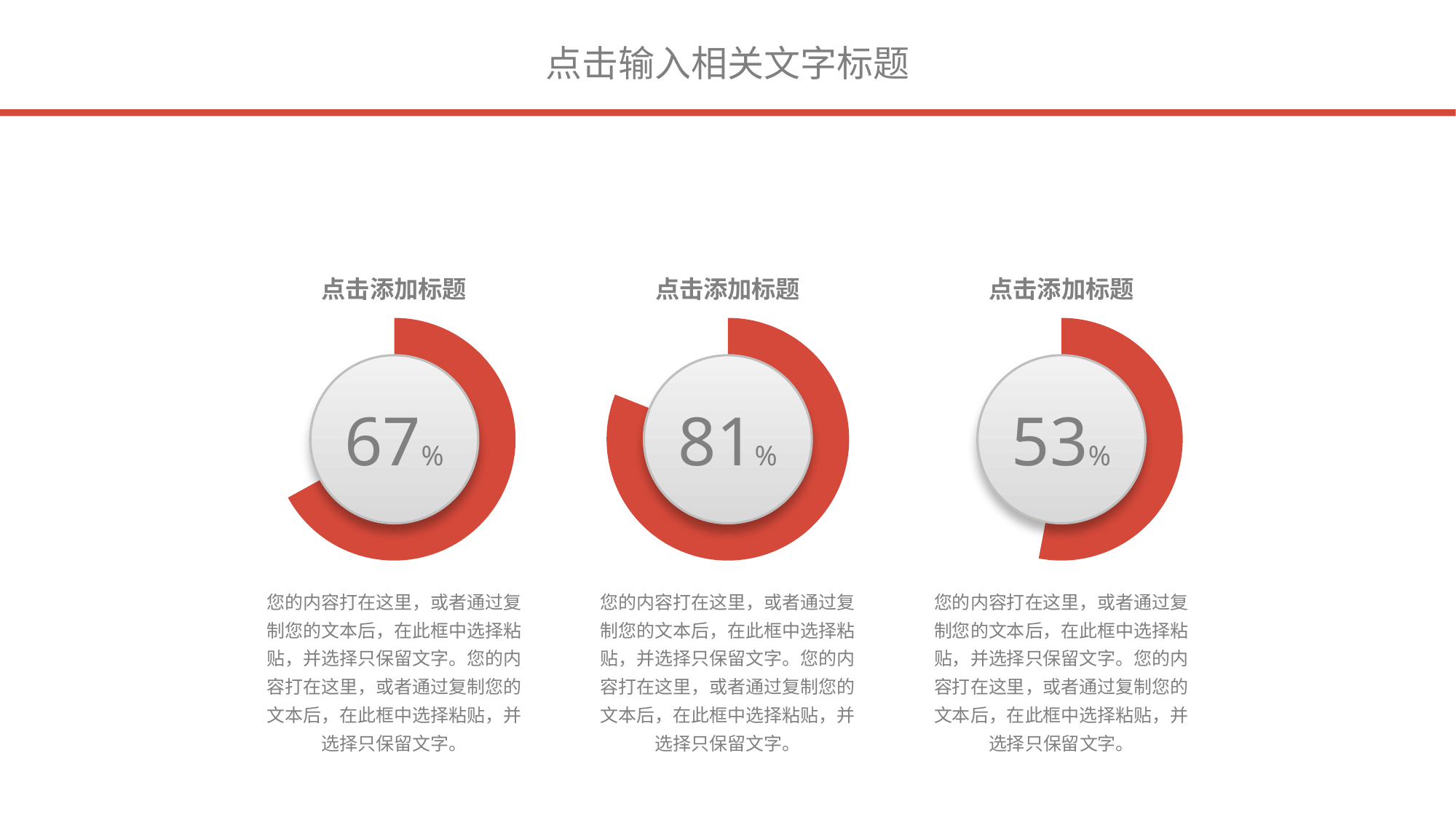
What colour is the filled arc in each ring chart? red What kind of chart is used to display each percentage on the slide? ring (donut) chart What is the difference between the left chart's value and the right chart's value? 14% What is the difference between the middle chart's value and the left chart's value? 14% Which of the three ring charts shows the highest percentage? the middle one (81%) What value is shown in the left ring chart? 67% What value is shown in the right ring chart? 53% Which of the three ring charts shows the lowest percentage? the right one (53%) Is the value in the right ring chart greater or less than 50%? greater How many ring charts are on the slide? 3 Which is larger, the value in the left ring chart or the value in the right ring chart? the left ring chart (67%) What value is shown in the middle ring chart? 81%